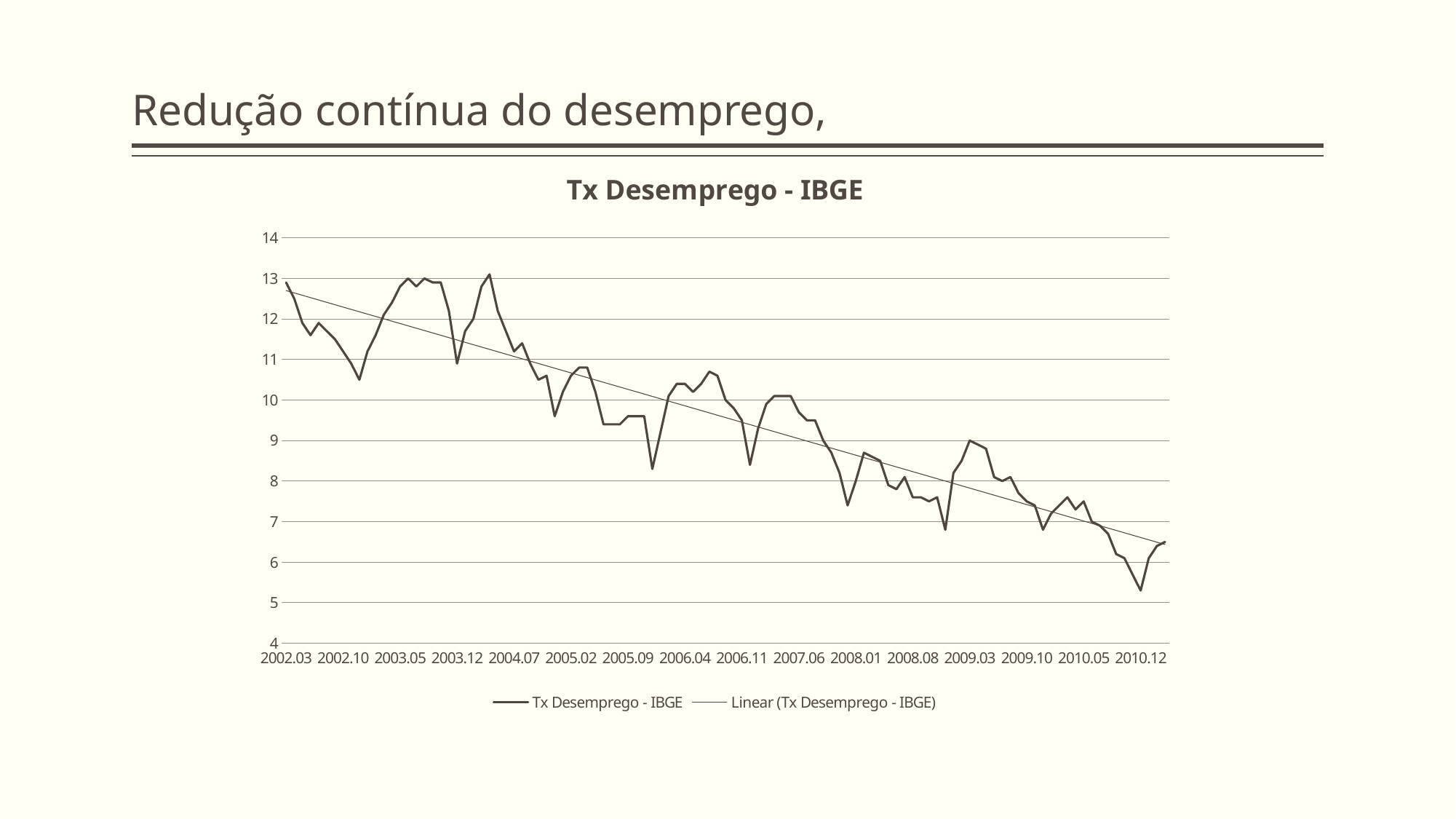
What is the title of the chart? Tx Desemprego - IBGE How many date labels are shown on the x axis? 16 Is the value for 2009.10 greater or less than 8? less Is the value for 2002.03 greater or less than 12? greater Is the value for 2008.08 greater or less than 8? less Overall, do the values of Tx Desemprego - IBGE rise or fall from 2002.03 to 2010.12? fall What is the second entry in the chart legend? Linear (Tx Desemprego - IBGE) How many series does the legend list? 2 What kind of chart is shown on the slide? line chart